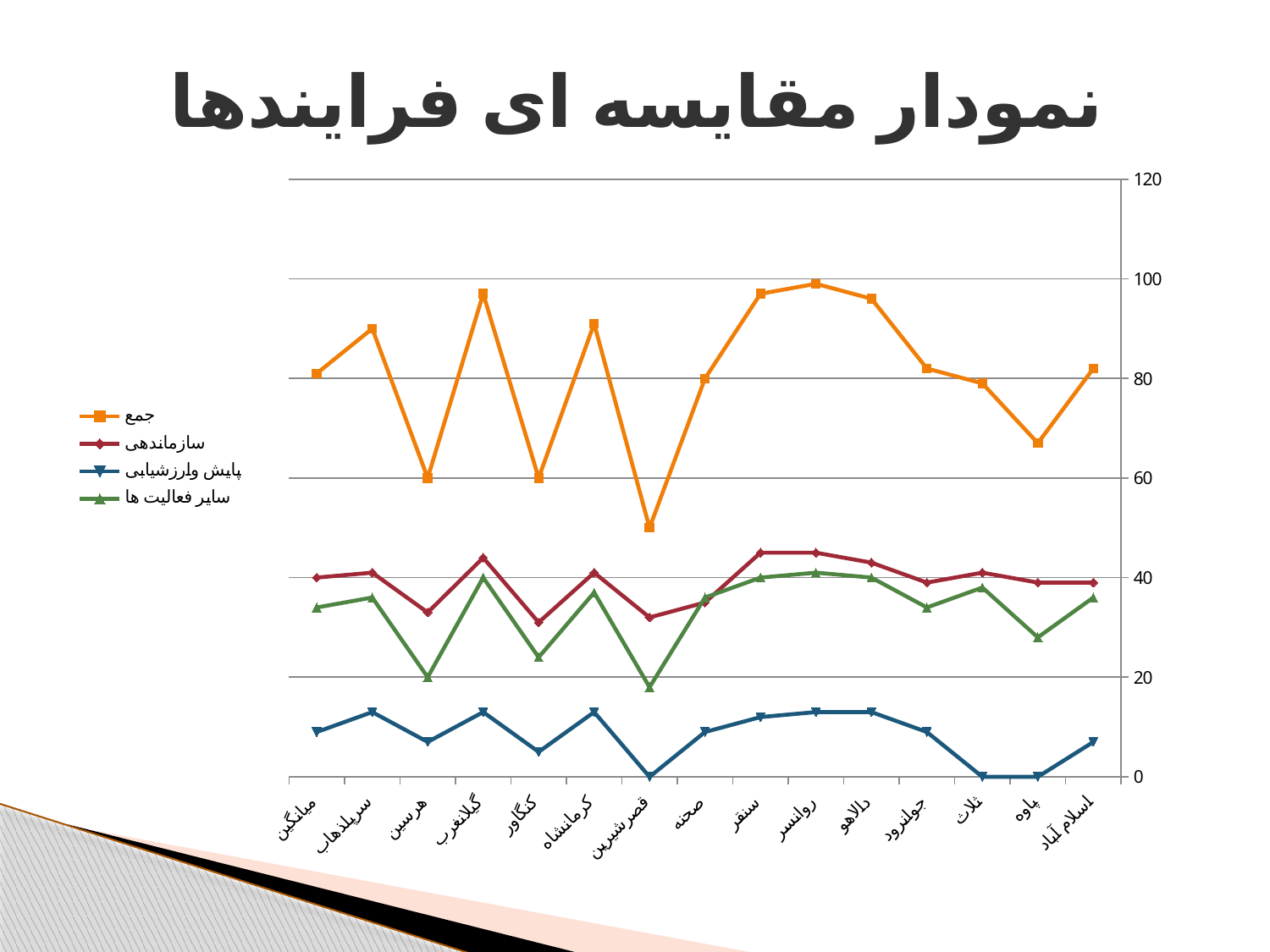
Is the value of جمع for پاوه greater or less than 80? less Is the value of جمع for روانسر greater or less than 80? greater How many series does the legend list? 4 What is the title of the chart? نمودار مقایسه ای فرایندها How many categories are shown along the x axis? 15 What kind of chart is shown on the slide? line chart Is the value of پایش وارزشیابی for روانسر greater or less than 20? less Which has the larger جمع value, سرپلذهاب or هرسین? سرپلذهاب Which has the larger سایر فعالیت ها value, گیلانغرب or کنگاور? گیلانغرب What is the value of پایش وارزشیابی for قصرشیرین? 0 Which category has the lowest value for the جمع series? قصرشیرین